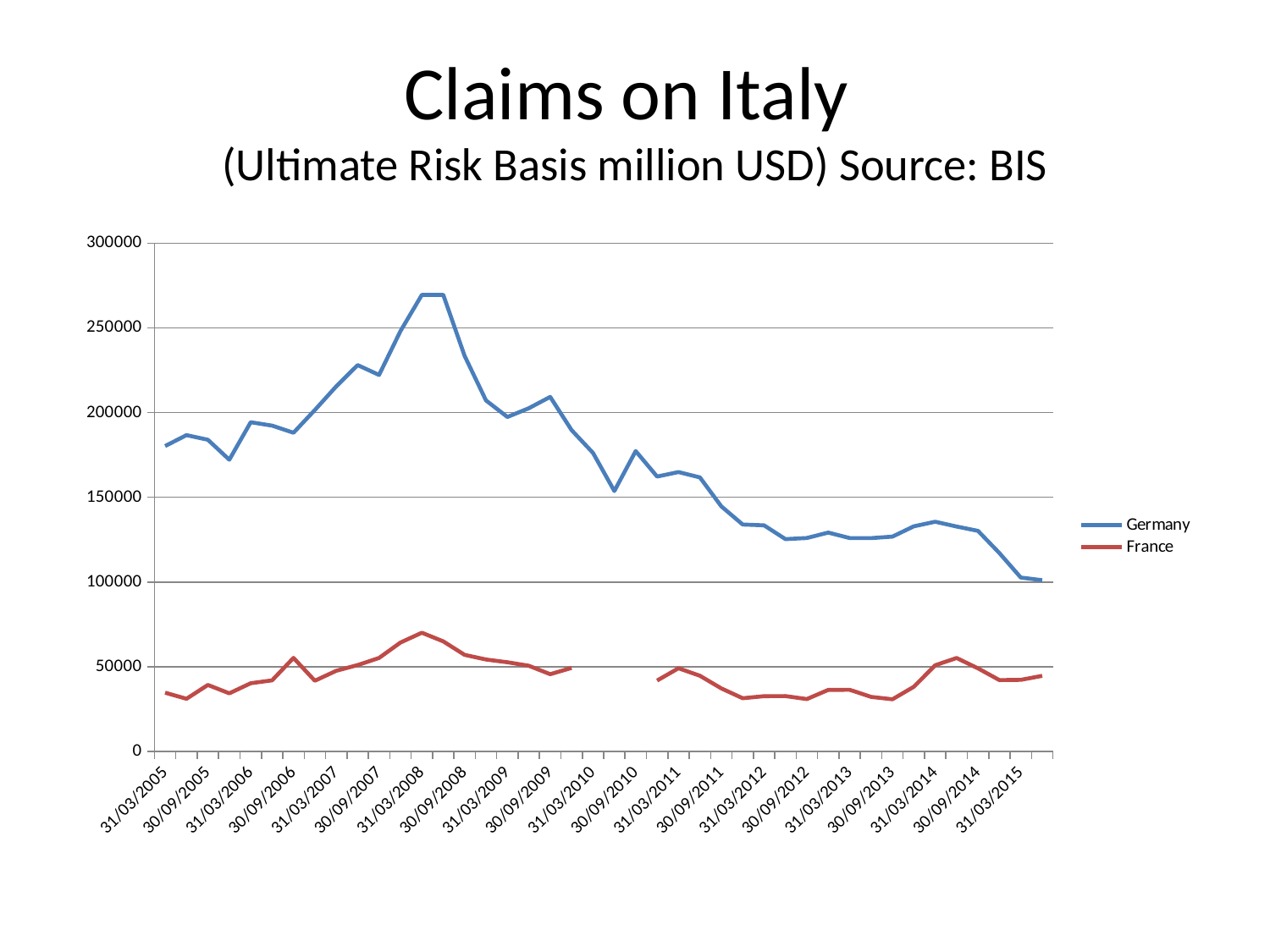
Is the value for France at 31/03/2012 greater or less than 50000? less Is the value for France at 31/03/2008 greater or less than 50000? greater Which two series are listed in the legend? Germany and France What kind of chart is shown on the slide? Line chart At which date does the France series reach its highest value? 31/03/2008 What is the title of the chart? Claims on Italy Is the value for Germany at 31/03/2005 greater or less than 150000? greater How many series does the legend list? 2 Do the values for Germany rise or fall between 31/03/2008 and 31/03/2015? Fall